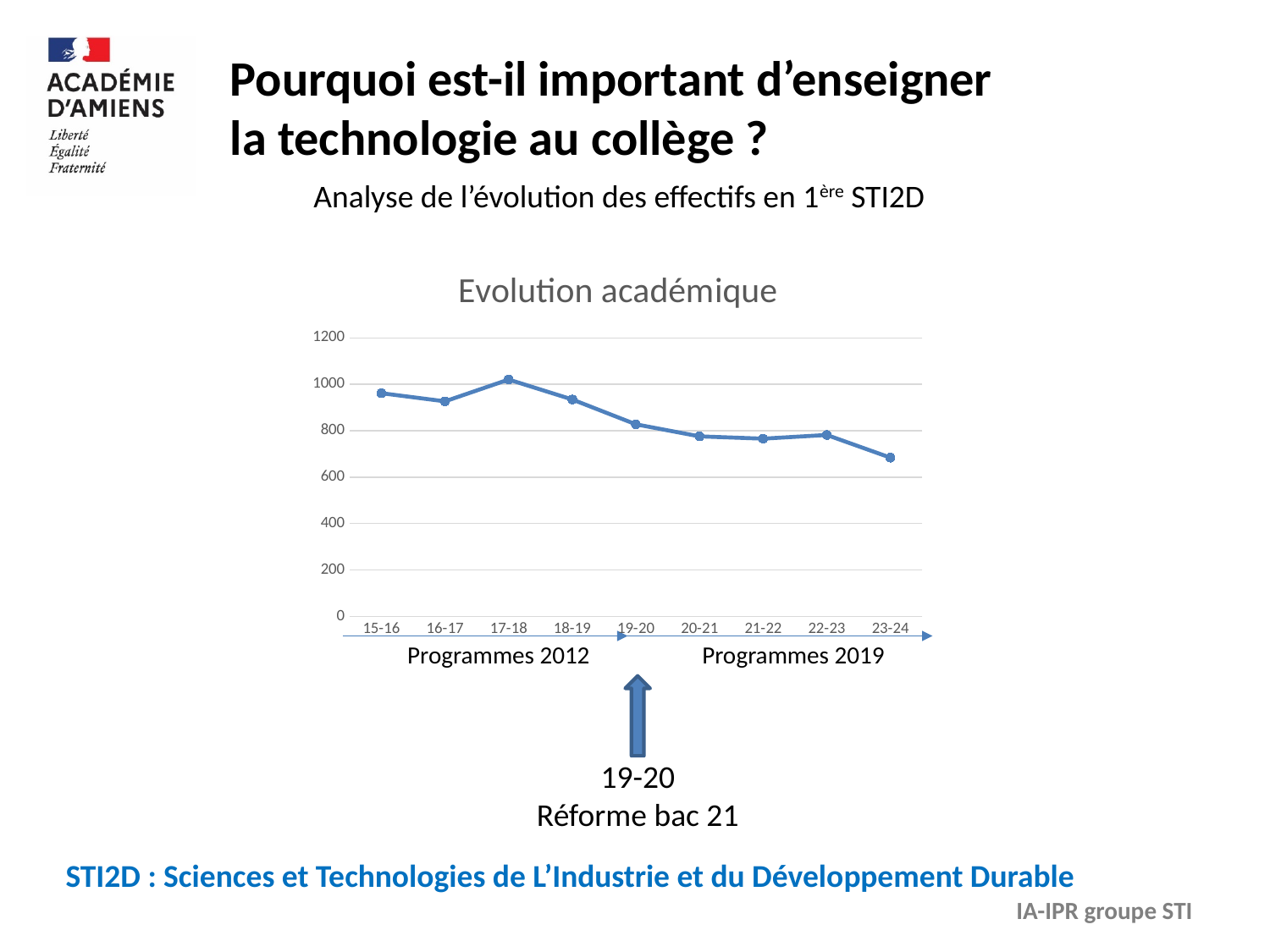
What kind of chart is shown on the slide? line chart Overall, do the values rise or fall from 15-16 to 23-24? fall Is the value for 17-18 greater or less than 1000? greater What is the title of the chart? Evolution académique Which school year has the lowest value on the chart? 23-24 Is the value for 23-24 greater or less than 800? less Which school year has the highest value on the chart? 17-18 Is the value for 15-16 greater or less than 1000? less Which is larger, the value for 17-18 or the value for 18-19? 17-18 Which programme label is shown under the x axis for the years before 19-20? Programmes 2012 How many school years are plotted on the x axis of the chart? 9